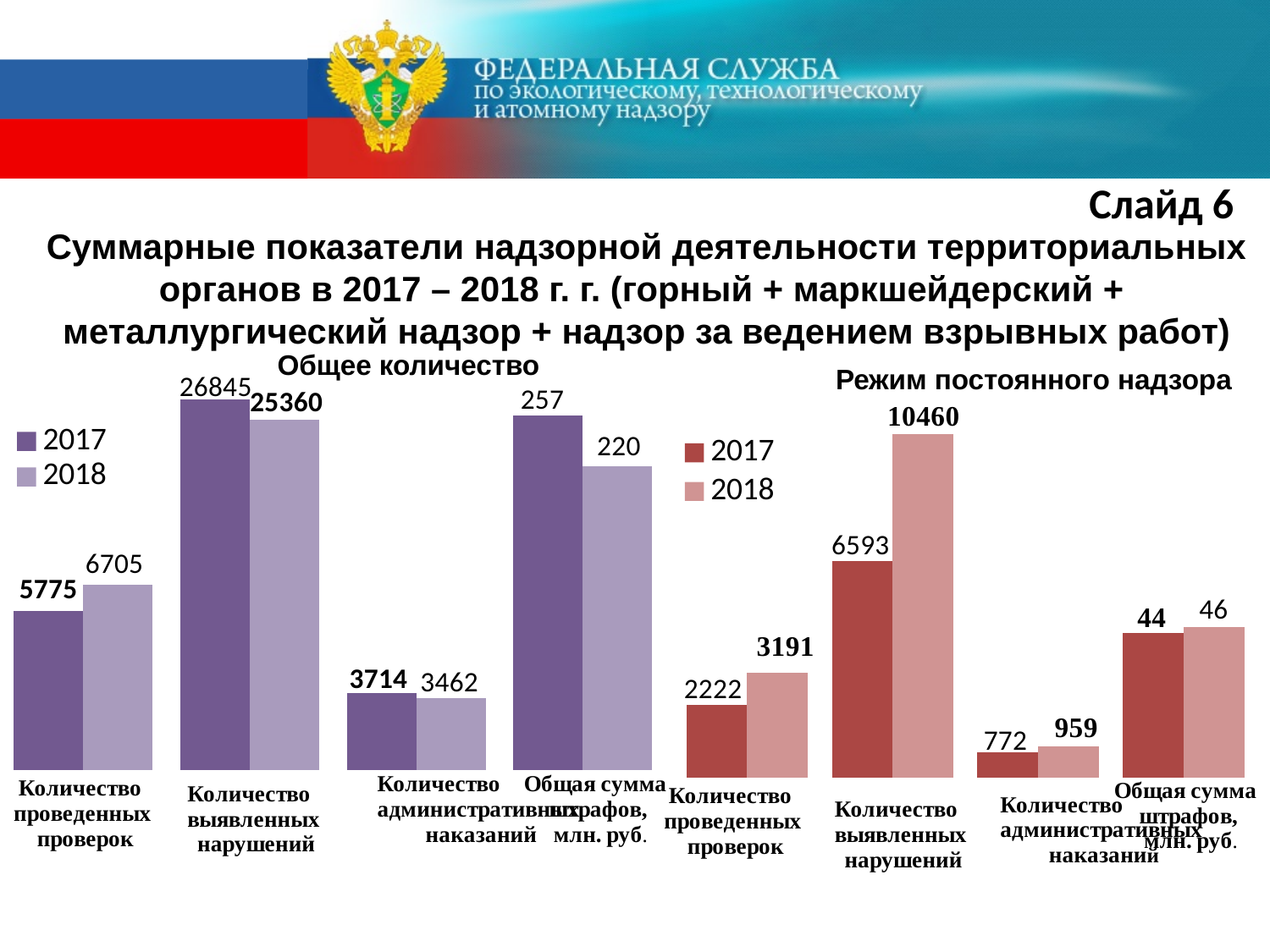
In the chart titled "Общее количество", which category has the highest 2017 value? Количество выявленных нарушений In the chart titled "Режим постоянного надзора", what is the 2018 value for "Количество выявленных нарушений"? 10460 In the chart titled "Общее количество", what is the difference between the 2017 and 2018 values for "Количество административных наказаний"? 252 What type of chart is the chart titled "Общее количество"? Bar chart In the chart titled "Общее количество", what is the 2017 value for "Количество проведенных проверок"? 5775 In the chart titled "Общее количество", what is the 2018 value for "Количество выявленных нарушений"? 25360 In the chart titled "Режим постоянного надзора", which category has the lowest 2018 value? Общая сумма штрафов, млн. руб. How many series does the legend of the chart titled "Режим постоянного надзора" list? 2 In the chart titled "Общее количество", which is larger for "Общая сумма штрафов, млн. руб.": the 2017 value or the 2018 value? 2017 In the chart titled "Режим постоянного надзора", what is the difference between the 2018 and 2017 values for "Количество проведенных проверок"? 969 In the chart titled "Режим постоянного надзора", which is larger for "Количество административных наказаний": the 2017 value or the 2018 value? 2018 In the chart titled "Режим постоянного надзора", what is the 2017 value for "Общая сумма штрафов, млн. руб."? 44